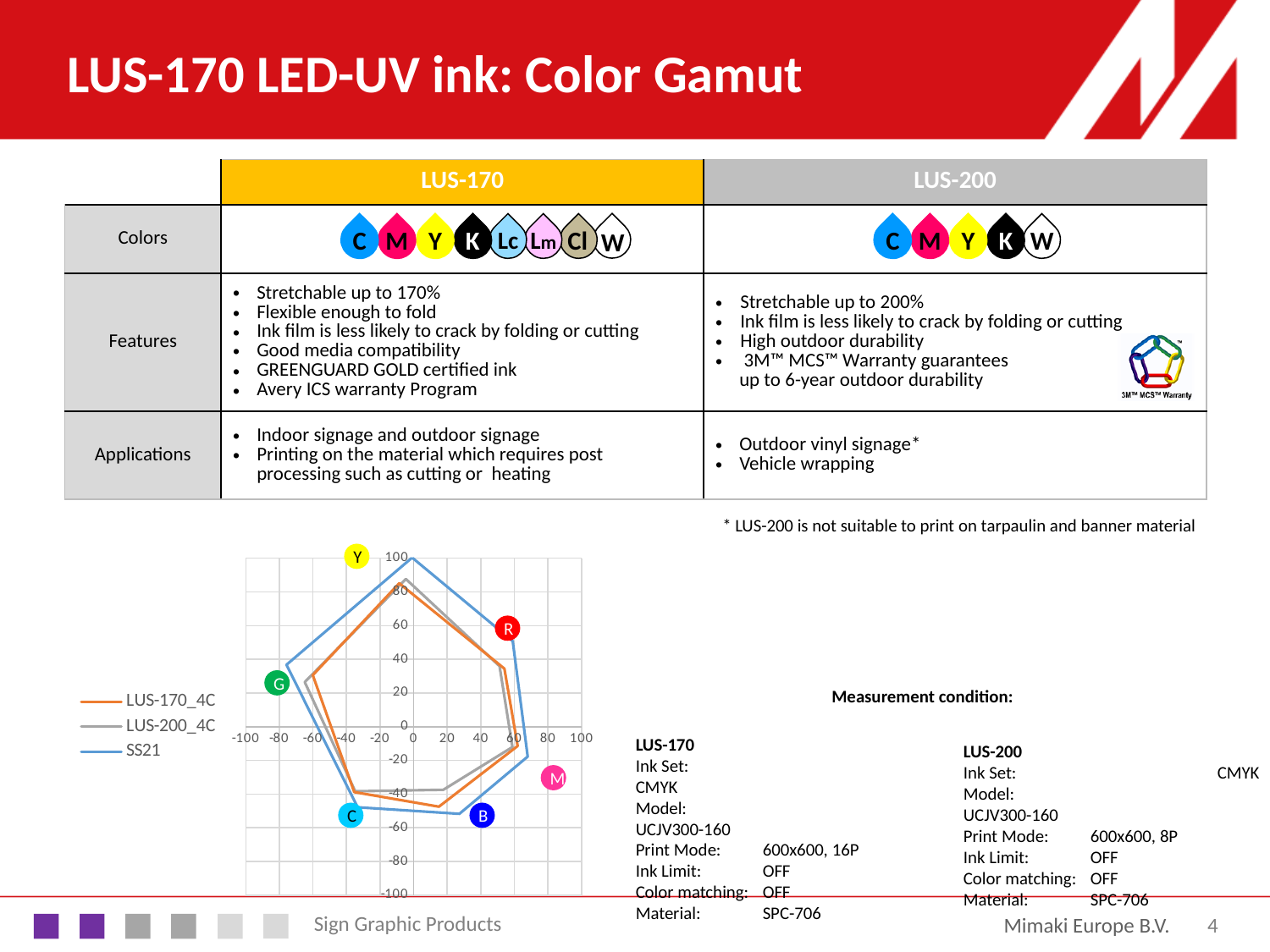
Which series in the color gamut chart covers the largest area? SS21 In the color gamut chart, which series reaches further toward the G (green) marker, LUS-170_4C or SS21? SS21 What are the three series named in the legend of the color gamut chart? LUS-170_4C, LUS-200_4C, SS21 What is the minimum value shown on the horizontal axis of the color gamut chart? -100 Which colour is used for the SS21 series in the color gamut chart? Blue Is the topmost point of the SS21 series in the color gamut chart greater or less than 80 on the vertical axis? greater What is the maximum value shown on the vertical axis of the color gamut chart? 100 How many colour markers (Y, R, G, M, C, B) are placed around the color gamut chart? 6 Which series in the color gamut chart extends furthest toward the Y (top) marker? SS21 Is the lowest point of the SS21 series in the color gamut chart greater or less than -40 on the vertical axis? less How many series does the legend of the color gamut chart list? 3 Is the leftmost point of the SS21 series in the color gamut chart greater or less than -60 on the horizontal axis? less